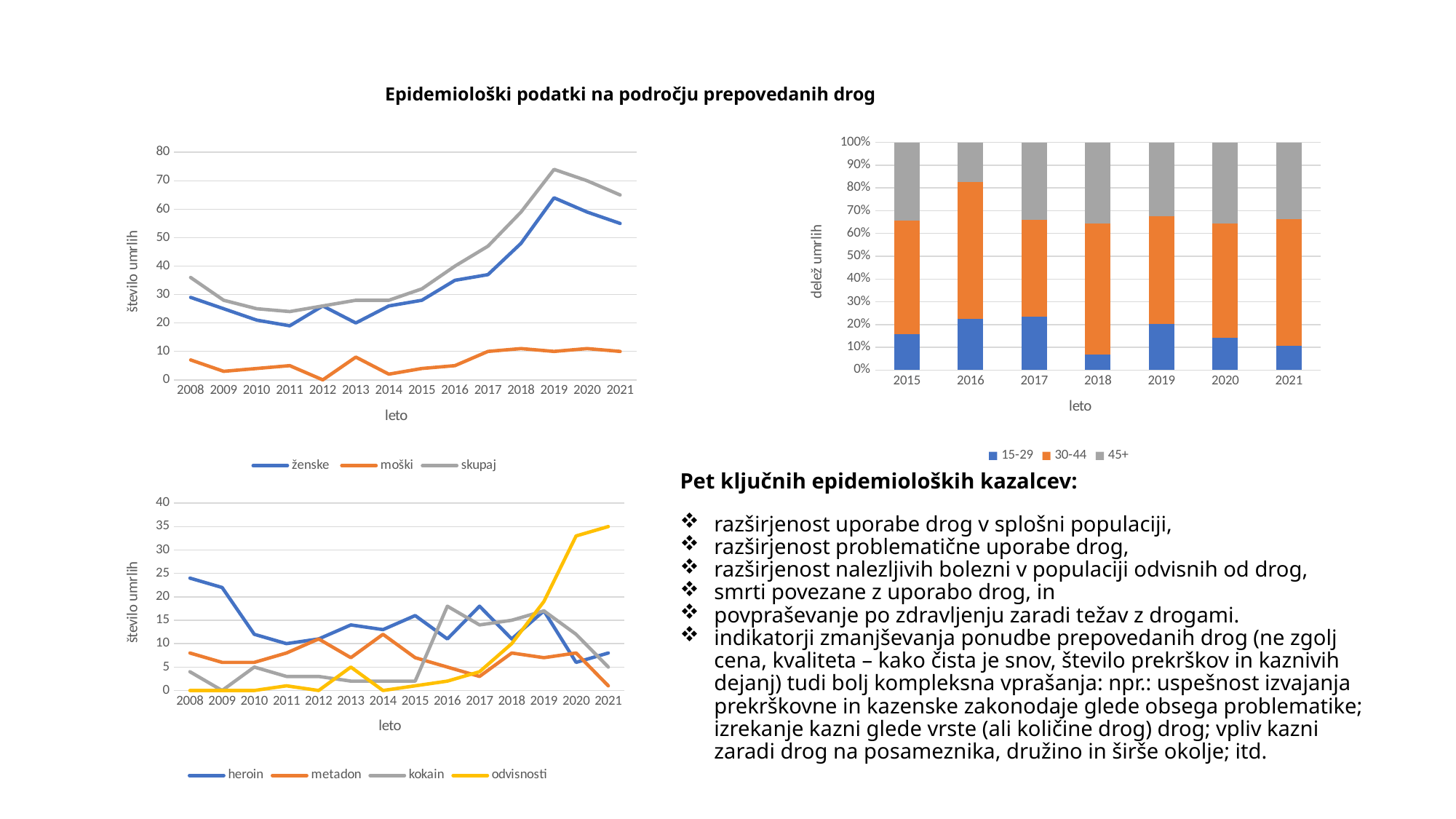
What type of chart is the top-right chart showing delež umrlih by age group? bar chart In the top-left chart, is the value for ženske in 2019 greater or less than 60? greater In the top-left chart, which series has the larger value in 2021, ženske or moški? ženske How many series does the legend of the bottom-left chart list? 4 How many series does the legend of the top-left chart list? 3 In the top-right chart, in which year is the share of the 15-29 group the smallest? 2018 In the top-left chart, in which year does the skupaj series reach its highest value? 2019 In the bottom-left chart, is the value for heroin in 2008 greater or less than 20? greater How many years are shown on the x axis of the top-left chart? 14 What type of chart is the top-left chart with the series ženske, moški and skupaj? line chart In the top-left chart, is the value for moški in 2012 greater or less than 10? less In the bottom-left chart, which series has the highest value in 2021? odvisnosti